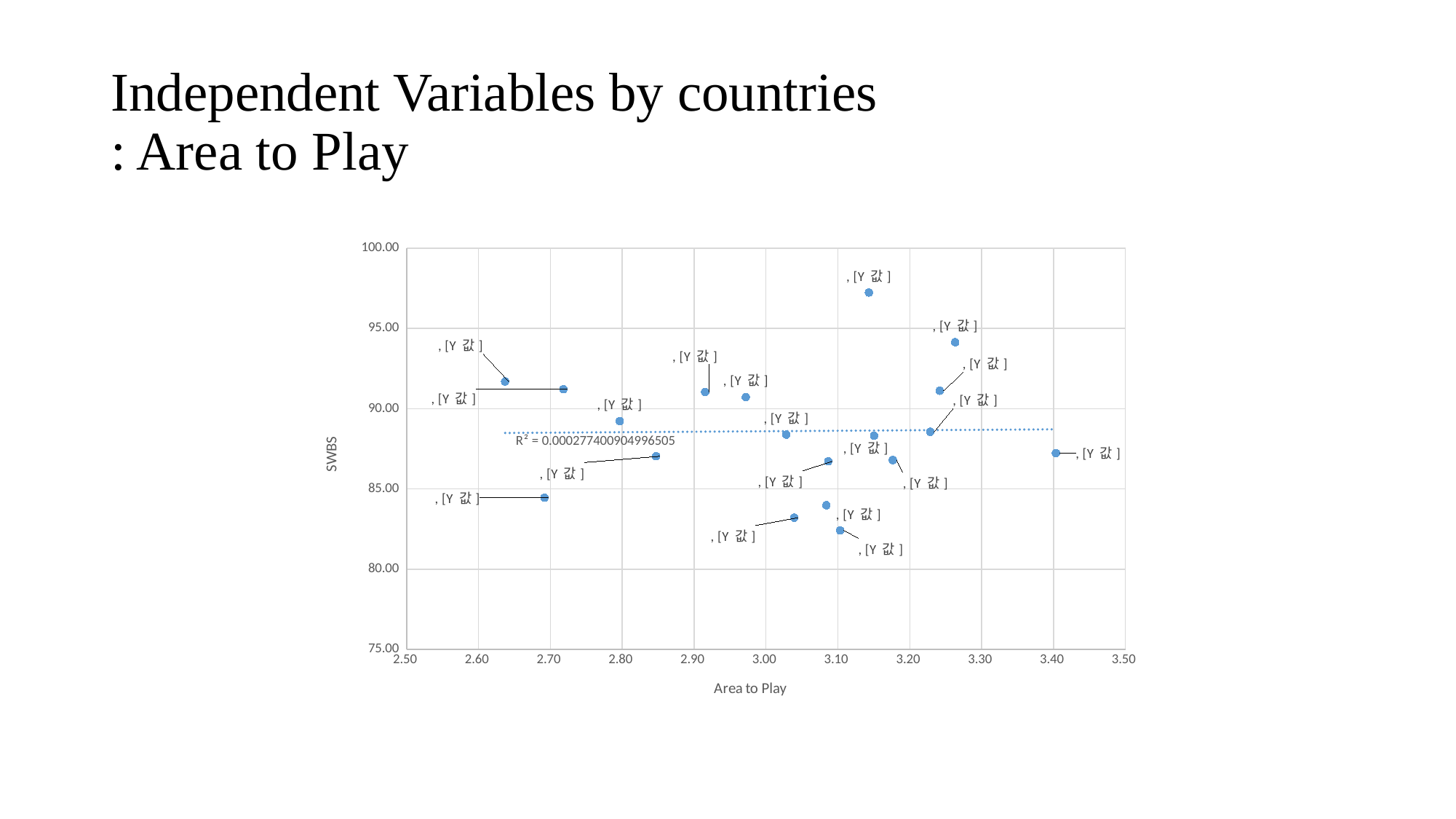
Is the SWBS value of the highest point on the chart greater or less than 95.00? greater What is the title of the vertical axis of the chart? SWBS How many data points are plotted on the chart? 19 Is the SWBS value of the lowest point on the chart greater or less than 85.00? less What is the title of the horizontal axis of the chart? Area to Play Does the dotted trendline on the chart rise steeply, fall steeply, or stay nearly flat as Area to Play increases? nearly flat What R² value is printed next to the trendline on the chart? 0.000277400904996505 Is the SWBS value of the rightmost point on the chart greater or less than 90.00? less What kind of chart is shown on the slide? scatter chart